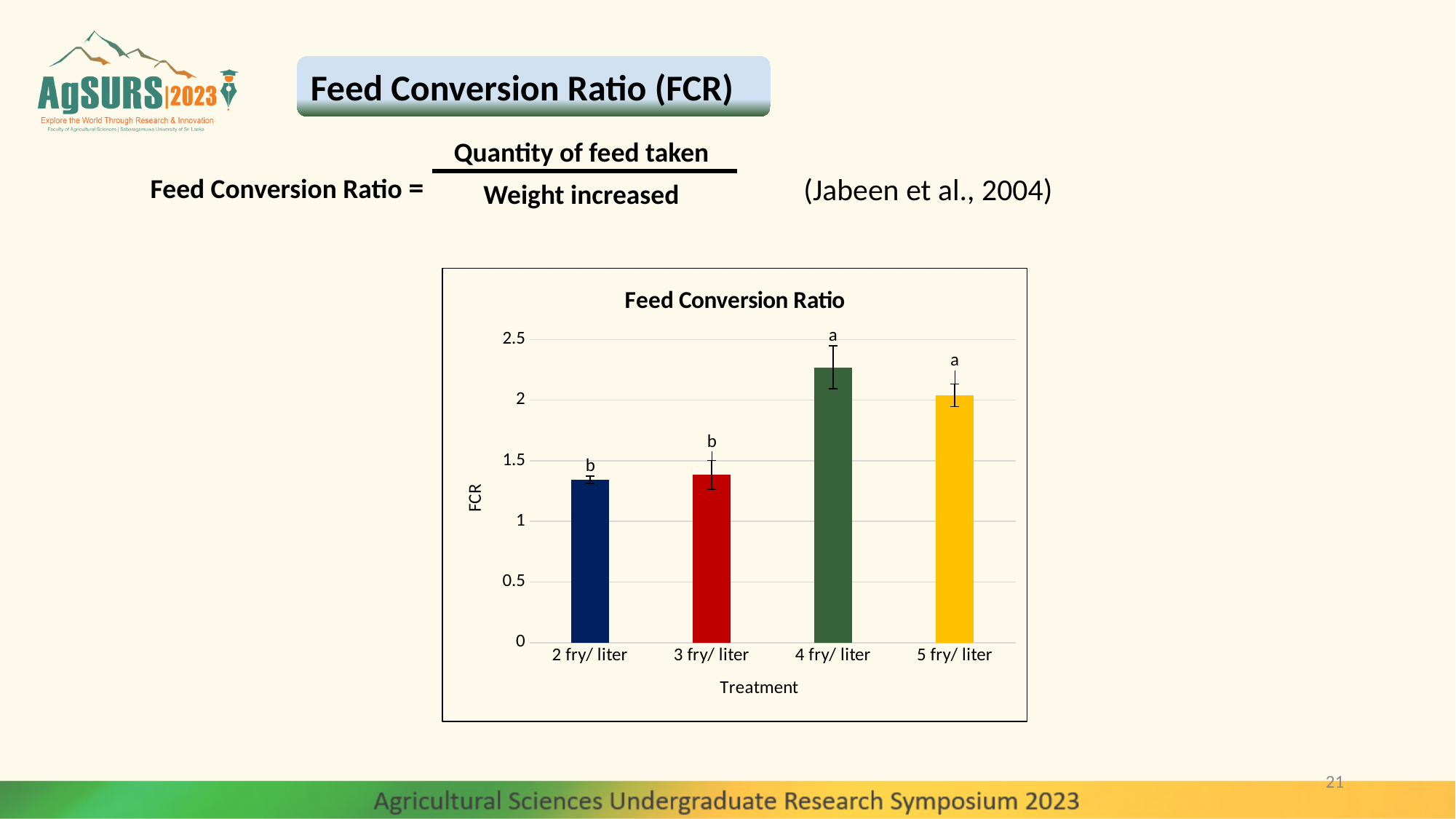
Is the FCR value for 4 fry/ liter greater or less than 2? greater Which treatment has the highest FCR value in the chart? 4 fry/ liter Is the FCR value for 5 fry/ liter greater or less than 2.5? less How many treatment categories are shown on the x axis of the chart? 4 Is the FCR value for 3 fry/ liter greater or less than 1.5? less What is the title of the chart? Feed Conversion Ratio What is the label of the x axis of the chart? Treatment What kind of chart is shown on the slide? bar chart Do the FCR values rise or fall from 2 fry/ liter to 4 fry/ liter? rise Which has a larger FCR value, 4 fry/ liter or 5 fry/ liter? 4 fry/ liter Which has a larger FCR value, 2 fry/ liter or 4 fry/ liter? 4 fry/ liter